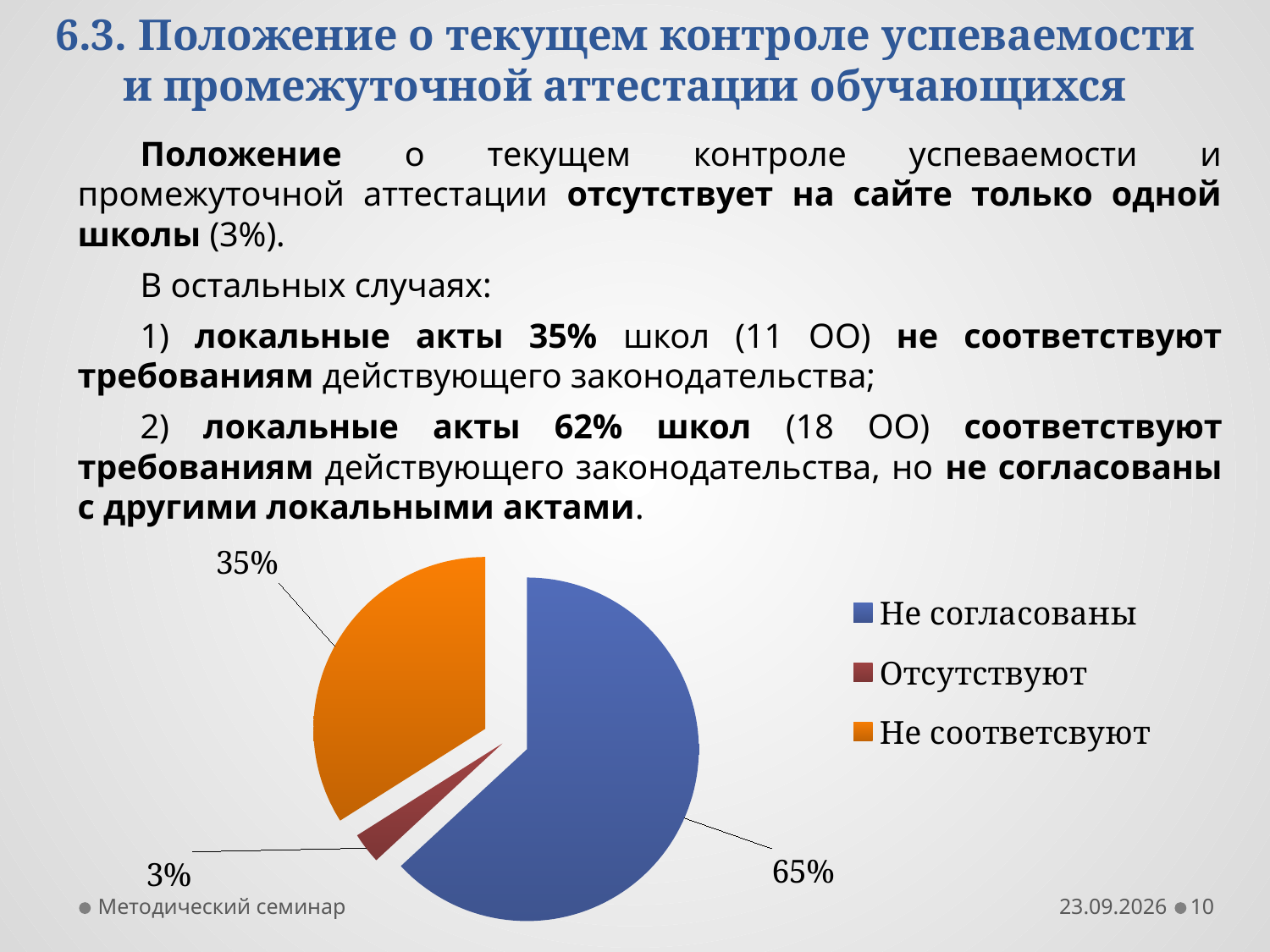
How many entries does the legend list? 3 What kind of chart is shown on the slide? pie chart What is the difference in percentage points between the "Не согласованы" slice and the "Не соответсвуют" slice? 30 What share of the pie does the "Не согласованы" slice have? 65% What share of the pie does the "Не соответсвуют" slice have? 35% Which category has the largest slice of the pie? Не согласованы What colour is the "Не соответсвуют" slice in the pie chart? orange Which category has the smallest slice of the pie? Отсутствуют What share of the pie does the "Отсутствуют" slice have? 3% Which is larger: the "Не согласованы" slice or the "Не соответсвуют" slice? Не согласованы How many slices does the pie chart have? 3 What colour is the "Отсутствуют" slice in the pie chart? dark red